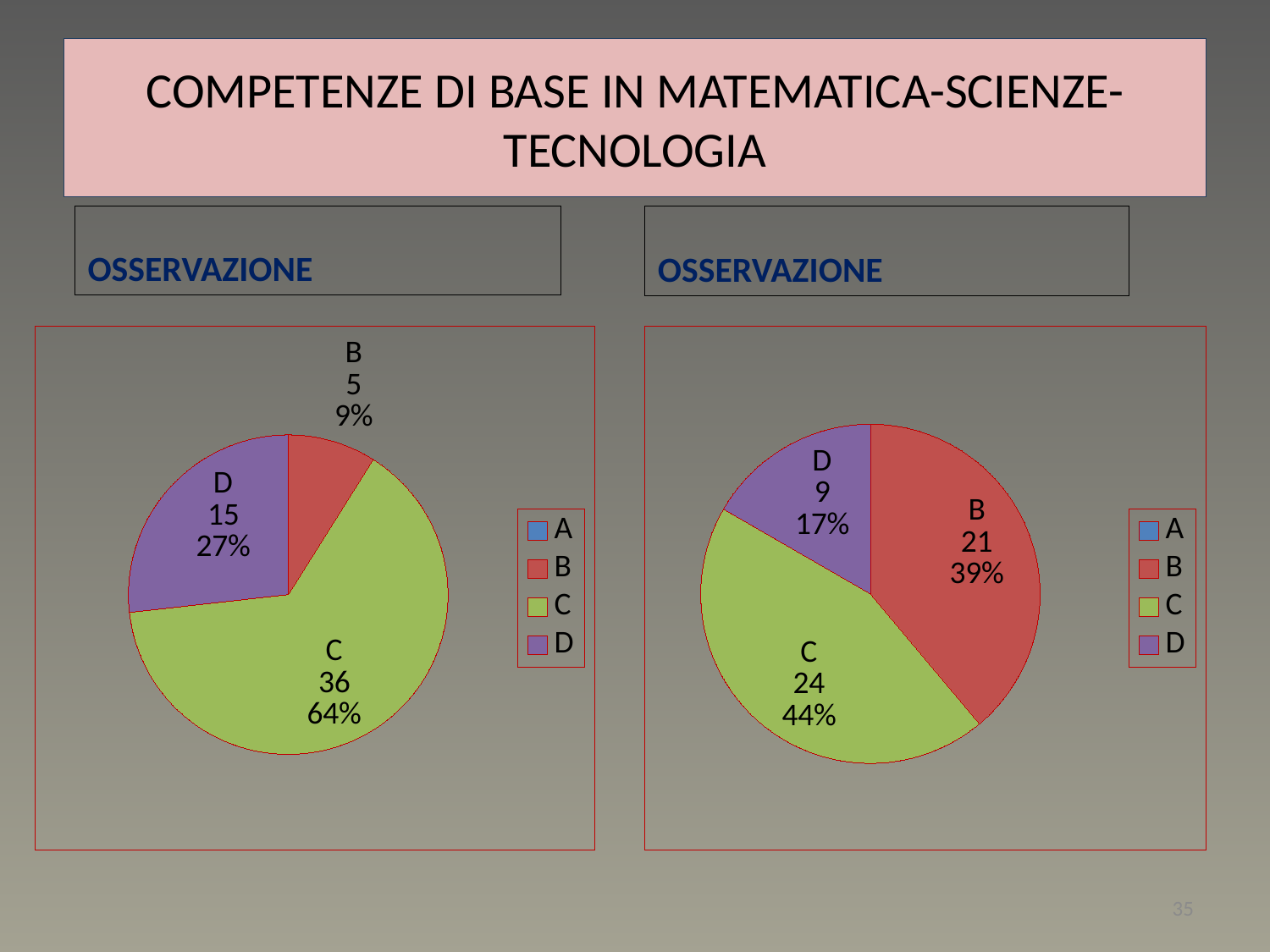
How many entries does the legend of the left pie chart list? 4 In the left pie chart, what share of the pie does category D have? 27% In the right pie chart, what is the value for category B? 21 In the left pie chart, which category has the largest slice? C In the right pie chart, what is the difference between the values for C and B? 3 What kind of chart is the left chart on the slide? pie chart In the right pie chart, which category has the smallest slice? D In the right pie chart, which is larger, the value for B or the value for D? B In the left pie chart, what is the value for category C? 36 In the left pie chart, what is the difference between the values for C and D? 21 In the left pie chart, what is the share of the pie for category B? 9% In the right pie chart, what share of the pie does category D have? 17%